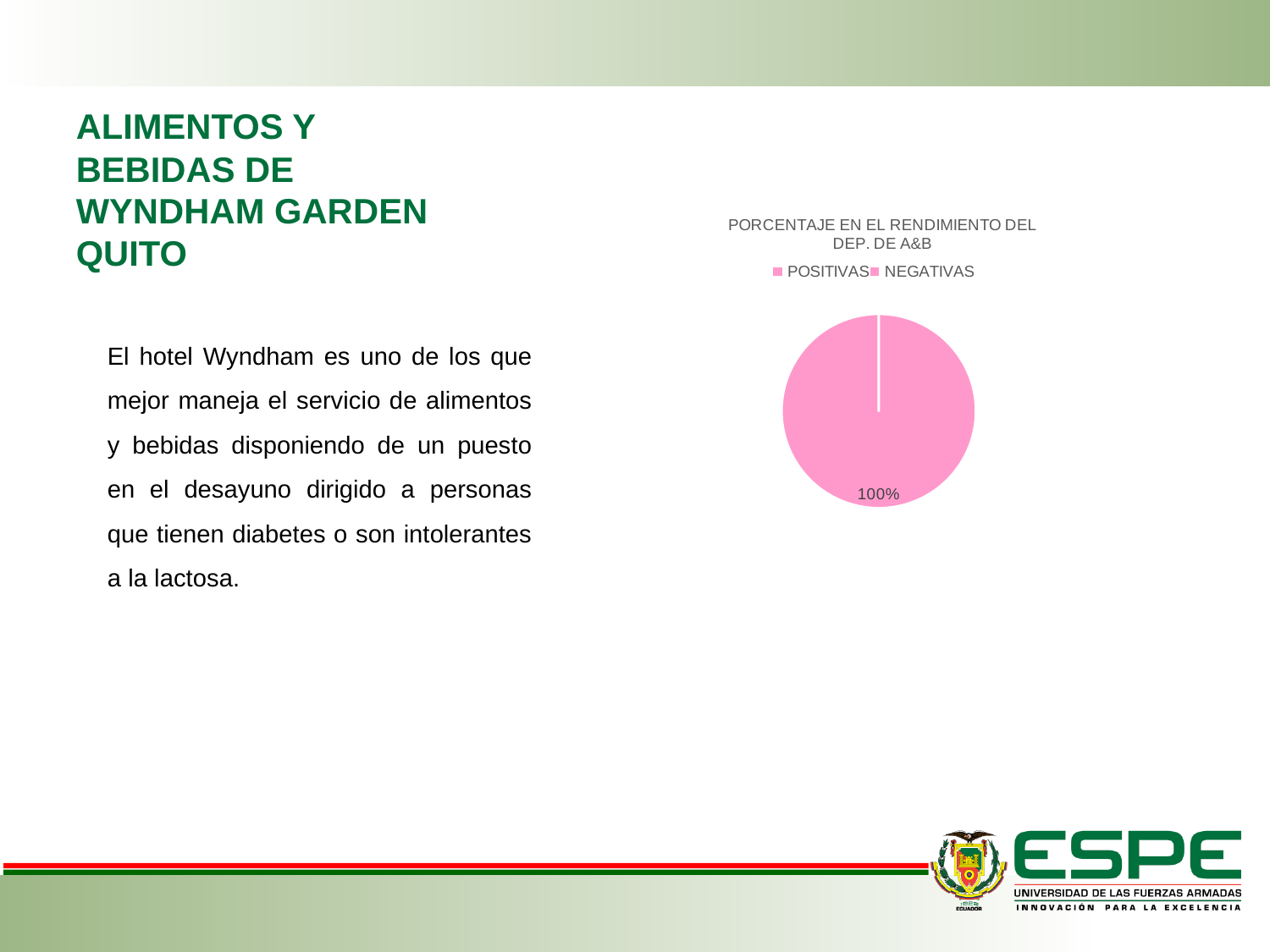
What are the two legend entries of the chart? POSITIVAS and NEGATIVAS What is the title of the chart on the slide? PORCENTAJE EN EL RENDIMIENTO DEL DEP. DE A&B Is the value labelled on the pie chart greater or less than 50%? greater What percentage value is printed on the pie chart? 100% How many entries does the chart's legend list? 2 What kind of chart is shown on the slide? pie chart What share of the pie does the single labelled slice represent? 100% How many data labels are printed on the pie chart? 1